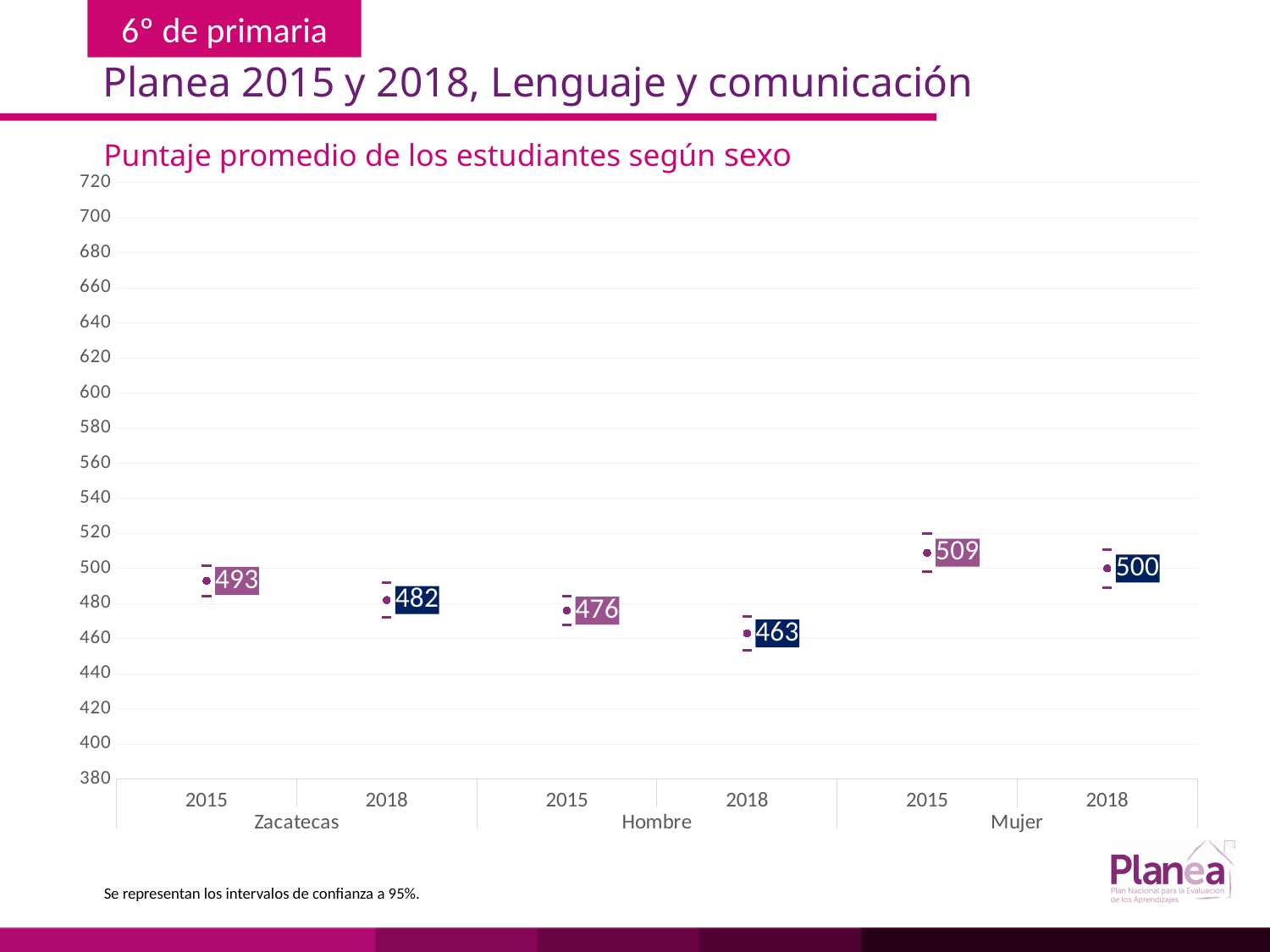
What is the average score for Zacatecas in 2015? 493 Which group and year has the highest average score? Mujer 2015 Which is larger, the Hombre score in 2015 or the Zacatecas score in 2018? Zacatecas 2018 From 2015 to 2018, do the Hombre scores rise or fall? fall What is the average score for Mujer in 2015? 509 How many data points are plotted on the chart? 6 What is the difference between the Mujer and Hombre scores in 2018? 37 What is the average score for Mujer in 2018? 500 What is the average score for Hombre in 2018? 463 What is the title of the chart? Puntaje promedio de los estudiantes según sexo What is the difference between the Zacatecas scores in 2015 and 2018? 11 Which group and year has the lowest average score? Hombre 2018